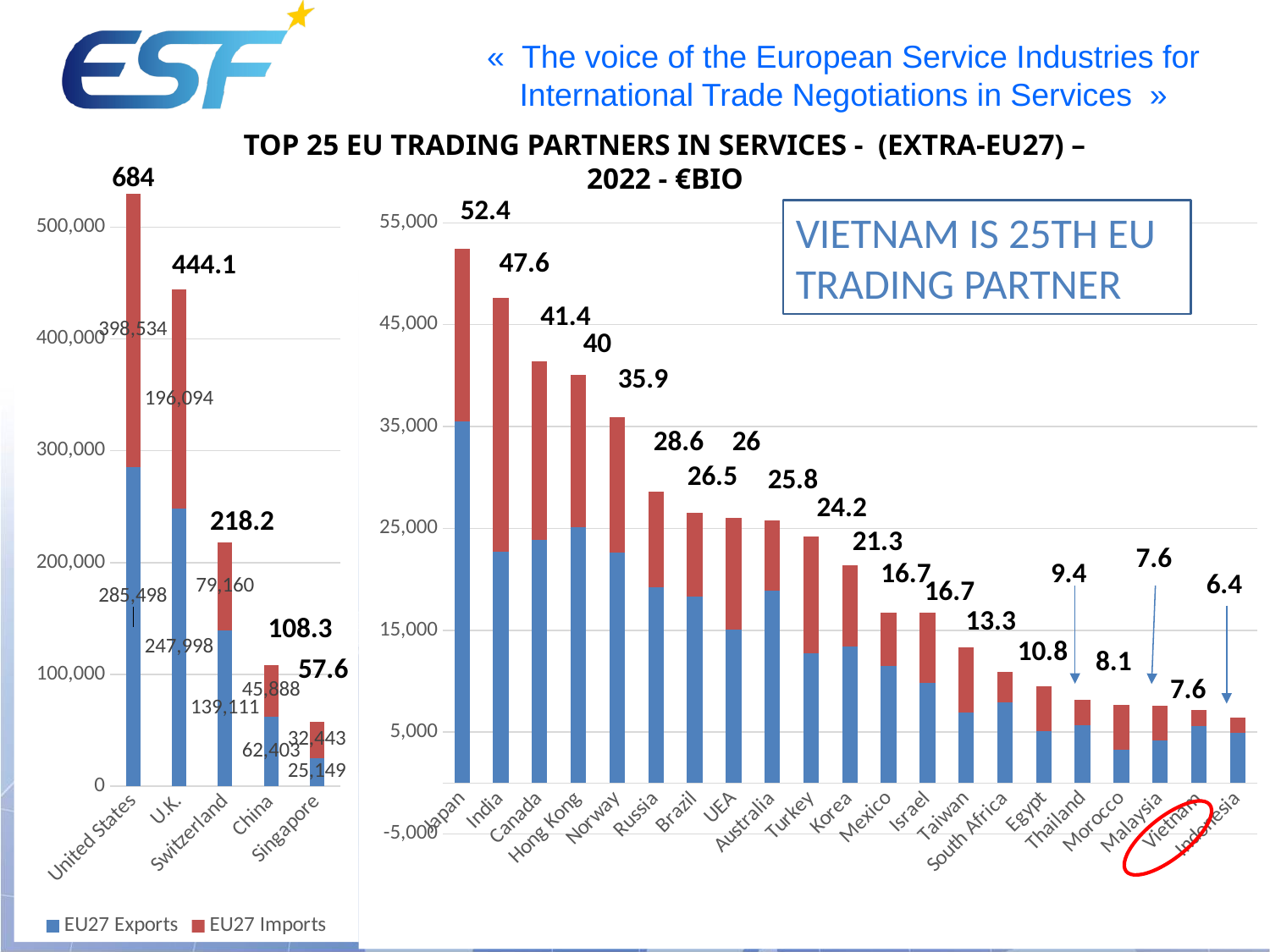
In the left chart, which country has the highest total bar? United States What kind of chart is used on this slide? Stacked bar chart How many series does the legend list? 2 In the right chart, what is the difference between the total labels for Japan and India? 4.8 In the left chart, what is the EU27 Exports value for the U.K.? 247,998 In the left chart, what is the total value shown above the United States bar? 684 In the right chart, do the total values rise or fall from left to right along the x axis? Fall In the left chart, what is the EU27 Imports value for Switzerland? 79,160 In the right chart, what is the total value labelled for Japan? 52.4 How many countries are shown on the x axis of the right chart? 21 In the left chart, which country has the lowest total bar? Singapore In the right chart, which country has the highest total bar? Japan